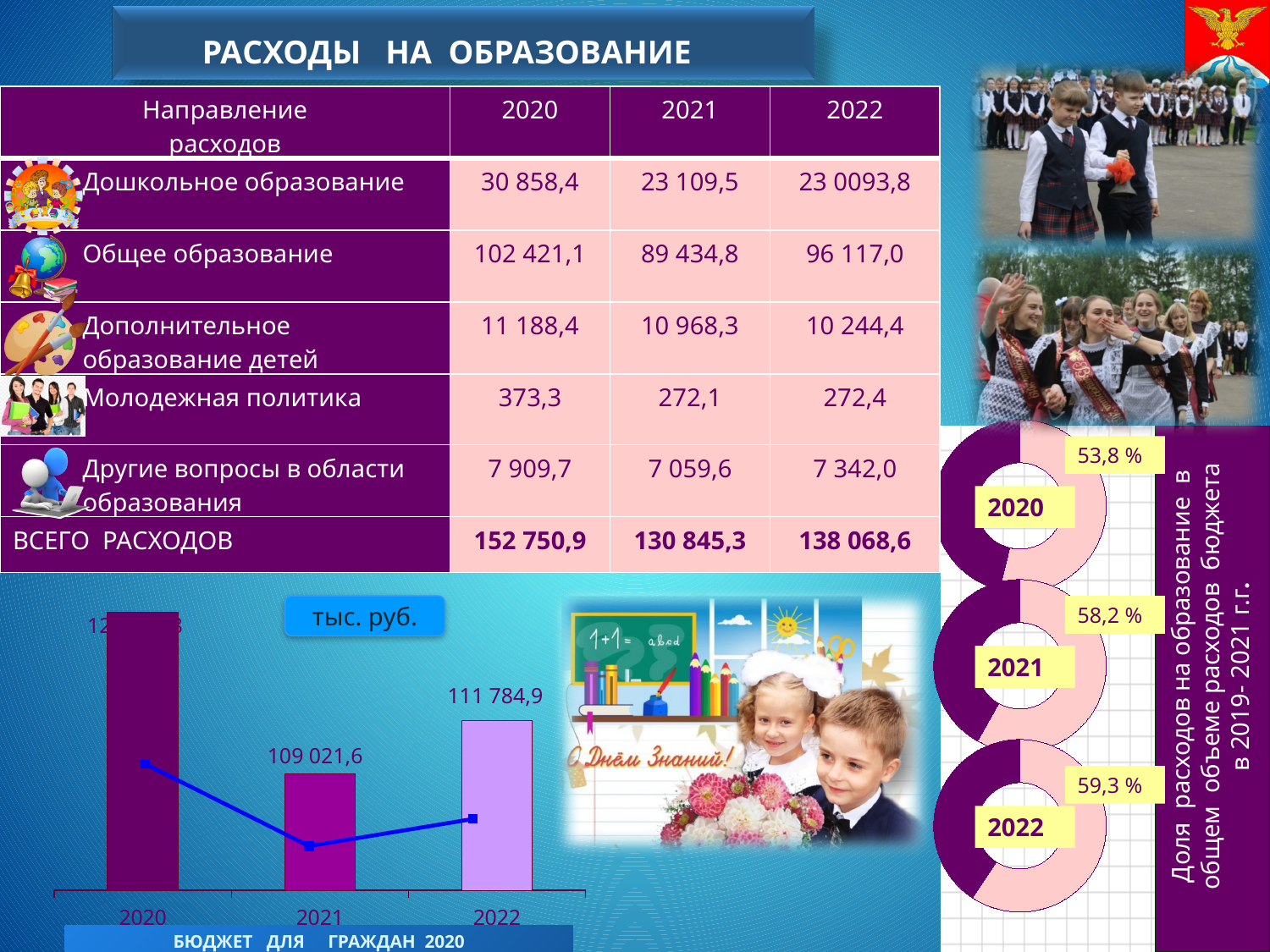
In the bar chart at the bottom left, what is the value for 2022? 111 784,9 In the bar chart at the bottom left, what is the difference between the values for 2022 and 2021? 2 763,3 In the bar chart at the bottom left, how many years are shown on the x axis? 3 In the share graphic on the right side of the slide, what percentage is shown for 2021? 58,2 % In the share graphic on the right side of the slide, which year has the highest percentage? 2022 In the bar chart at the bottom left, which year has the tallest bar? 2020 What kind of chart is shown at the bottom left of the slide? bar chart What unit is shown in the label box above the bar chart at the bottom left? тыс. руб. In the bar chart at the bottom left, does the value rise or fall from 2021 to 2022? rise In the bar chart at the bottom left, which year has the lowest value? 2021 In the bar chart at the bottom left, what is the value for 2021? 109 021,6 In the bar chart at the bottom left, which is larger, the value for 2021 or the value for 2022? 2022